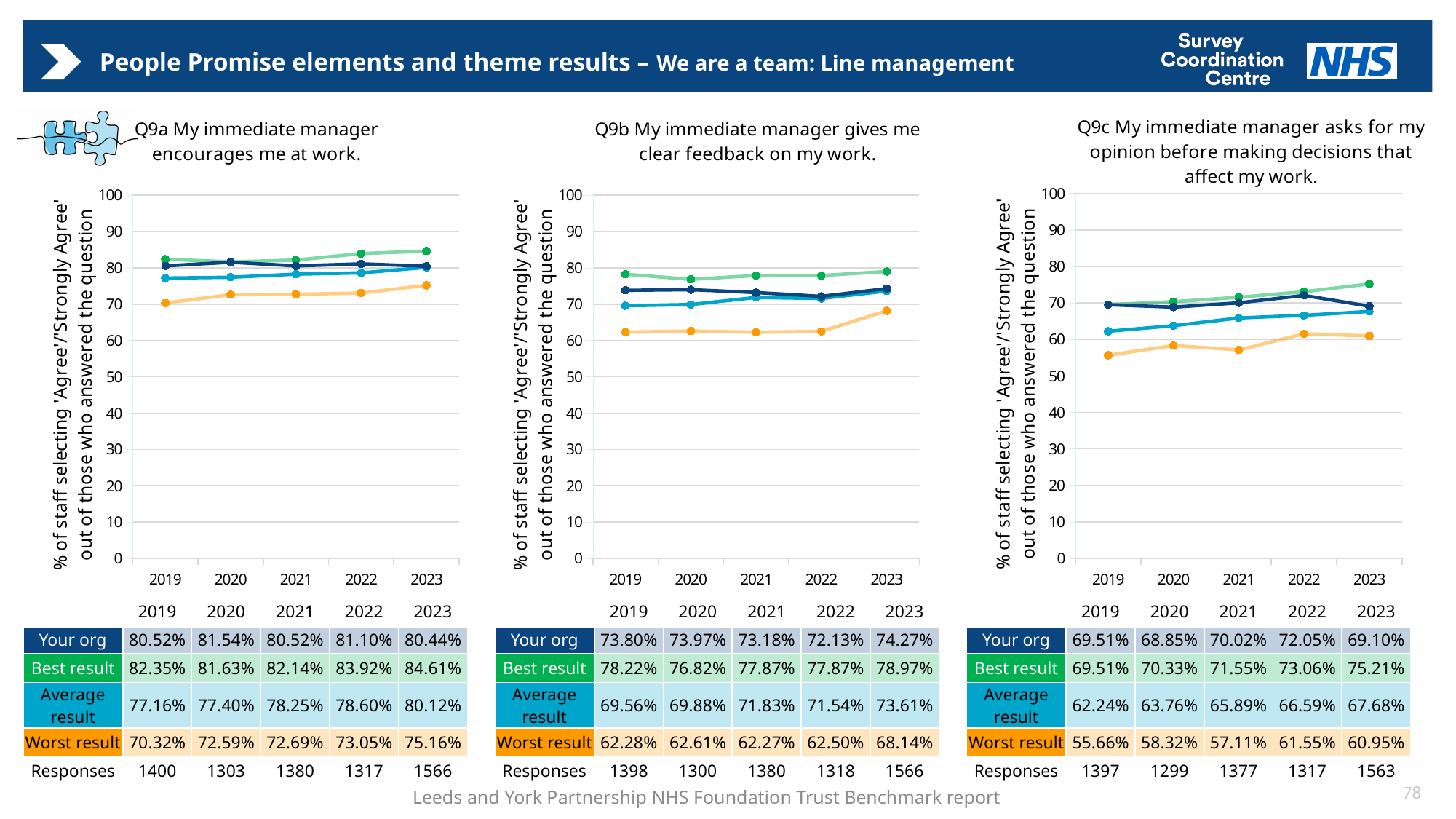
In the Q9c chart, does the 'Average result' line rise or fall from 2019 to 2023? Rise In the Q9c chart, what is the difference between the 'Best result' and 'Worst result' values for 2023? 14.26 percentage points How many years are plotted on the x axis of the Q9b chart? 5 In the Q9a chart, in which year was the 'Your org' value highest? 2020 In the Q9c chart, is the 'Worst result' value for 2019 greater or less than 60? less In the Q9a chart (My immediate manager encourages me at work), what is the 'Your org' value for 2023? 80.44% In the Q9c chart, in which year was the 'Worst result' value lowest? 2019 In the Q9a chart, what is the difference between the 'Best result' and 'Your org' values for 2023? 4.17 percentage points In the Q9b chart (My immediate manager gives me clear feedback on my work), what is the 'Best result' value for 2023? 78.97% In the Q9b chart, which is larger for 2019: the 'Your org' value or the 'Average result' value? Your org What kind of chart is used for Q9a? Line chart In the Q9c chart (My immediate manager asks for my opinion before making decisions that affect my work), what is the 'Worst result' value for 2019? 55.66%